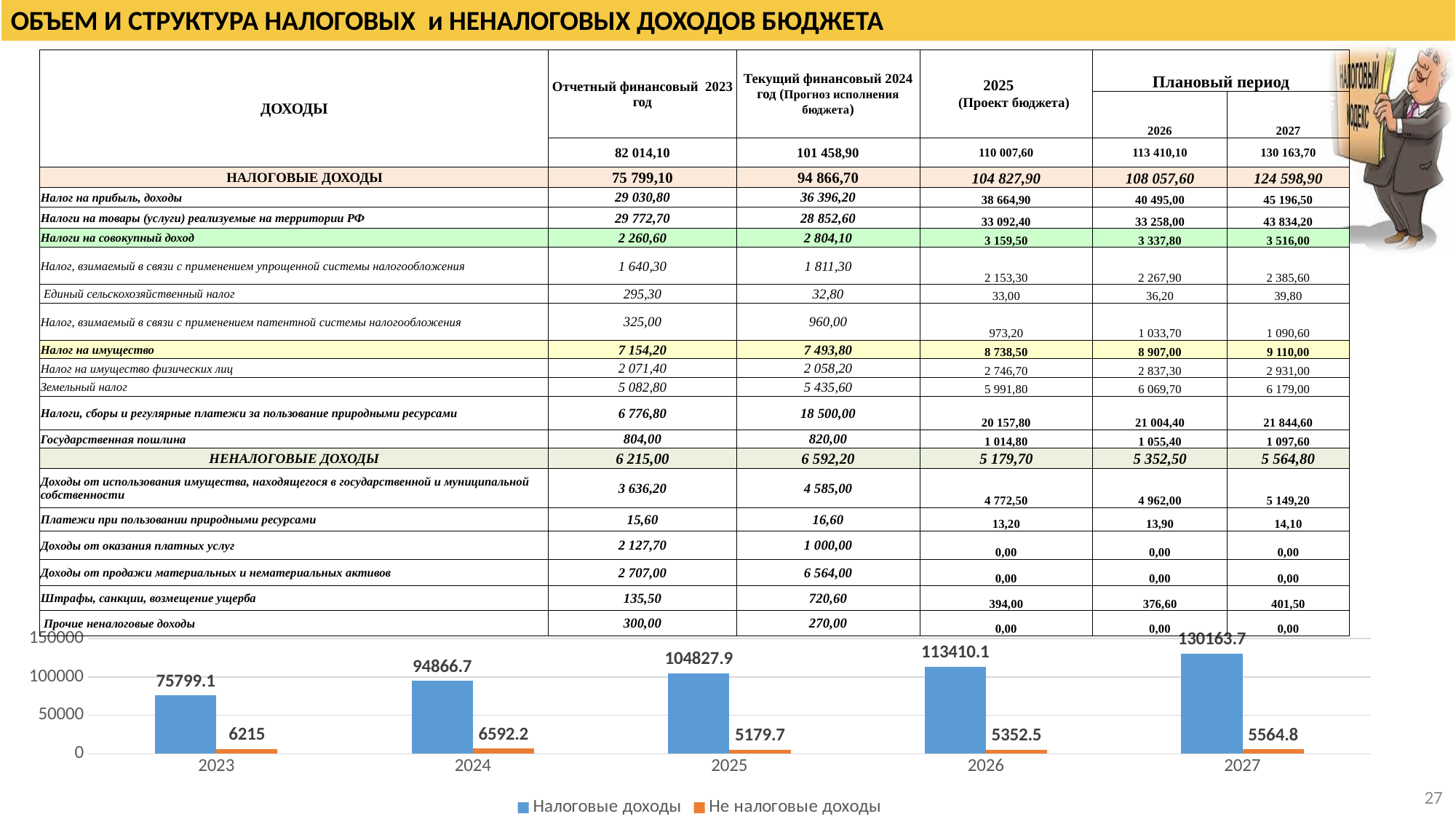
How many series does the legend of the bar chart at the bottom of the slide list? 2 In the bar chart at the bottom of the slide, which year has the highest value of Налоговые доходы? 2027 In the bar chart at the bottom of the slide, do the values of Налоговые доходы rise or fall from 2023 to 2027? rise In the bar chart at the bottom of the slide, is the value of Налоговые доходы for 2026 greater or less than 100000? greater In the bar chart at the bottom of the slide, which year has the lowest value of Не налоговые доходы? 2025 In the bar chart at the bottom of the slide, which is larger: Не налоговые доходы in 2023 or in 2027? 2023 In the bar chart at the bottom of the slide, what is the difference between Налоговые доходы in 2024 and in 2023? 19067.6 What kind of chart is shown at the bottom of the slide? bar chart How many years are shown on the x axis of the bar chart at the bottom of the slide? 5 In the bar chart at the bottom of the slide, what is the value of Не налоговые доходы for 2024? 6592.2 In the bar chart at the bottom of the slide, what is the value of Налоговые доходы for 2025? 104827.9 In the bar chart at the bottom of the slide, what is the value of Налоговые доходы for 2027? 130163.7